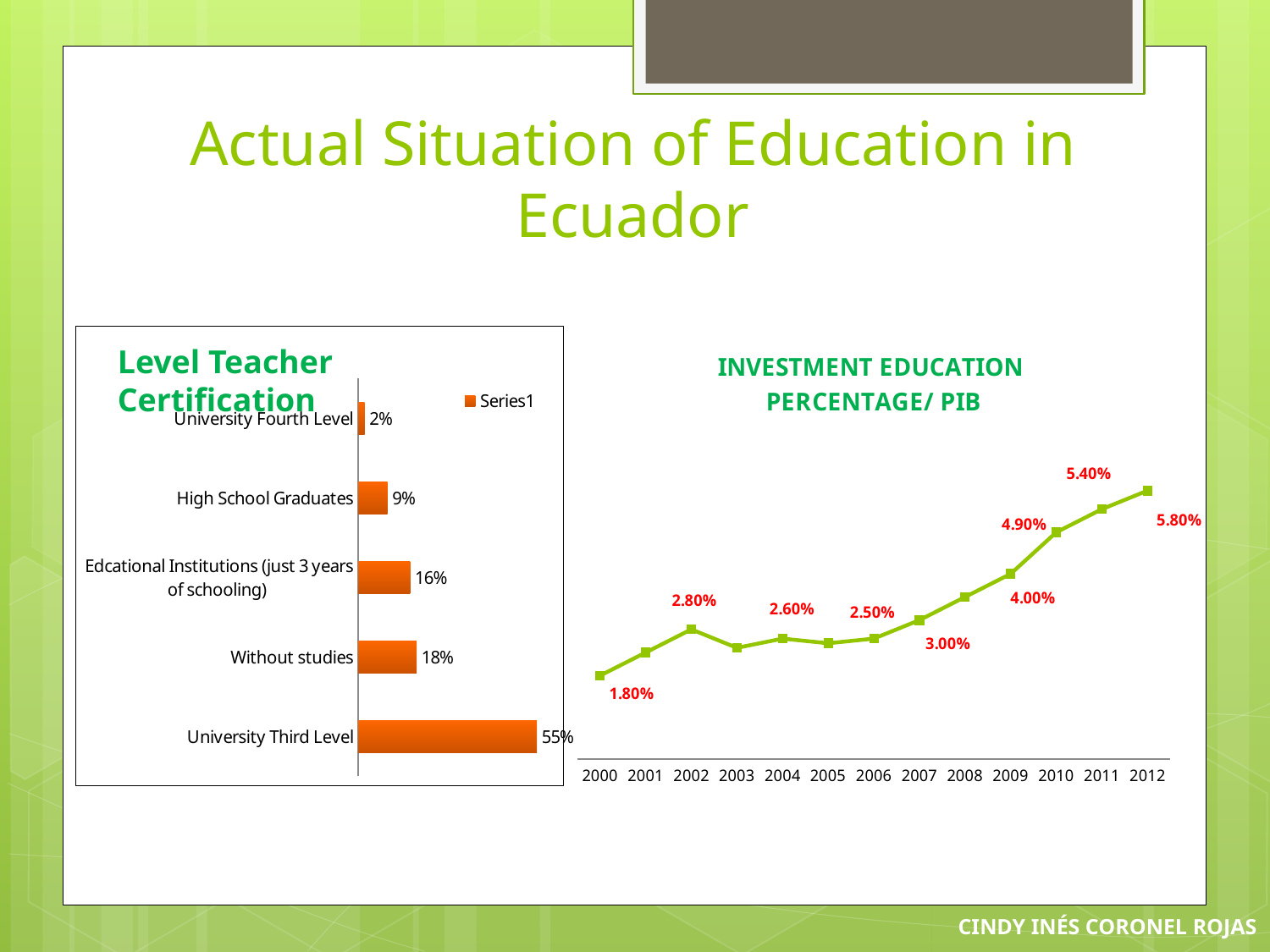
In the Level Teacher Certification chart, which is larger: High School Graduates or Without studies? Without studies In the Level Teacher Certification chart, what is the difference between Without studies and Edcational Institutions (just 3 years of schooling)? 2% In the Investment Education Percentage/ PIB chart, do the values generally rise or fall from 2000 to 2012? rise In the Investment Education Percentage/ PIB chart, what is the value for 2000? 1.80% In the Level Teacher Certification chart, which category has the lowest value? University Fourth Level In the Level Teacher Certification chart, what is the value for University Third Level? 55% What kind of chart is the Level Teacher Certification chart? bar chart In the Level Teacher Certification chart, what is the value for Without studies? 18% What is the legend entry shown in the Level Teacher Certification chart? Series1 In the Investment Education Percentage/ PIB chart, what is the value for 2012? 5.80% How many categories are shown in the Level Teacher Certification chart? 5 In the Level Teacher Certification chart, which category has the highest value? University Third Level